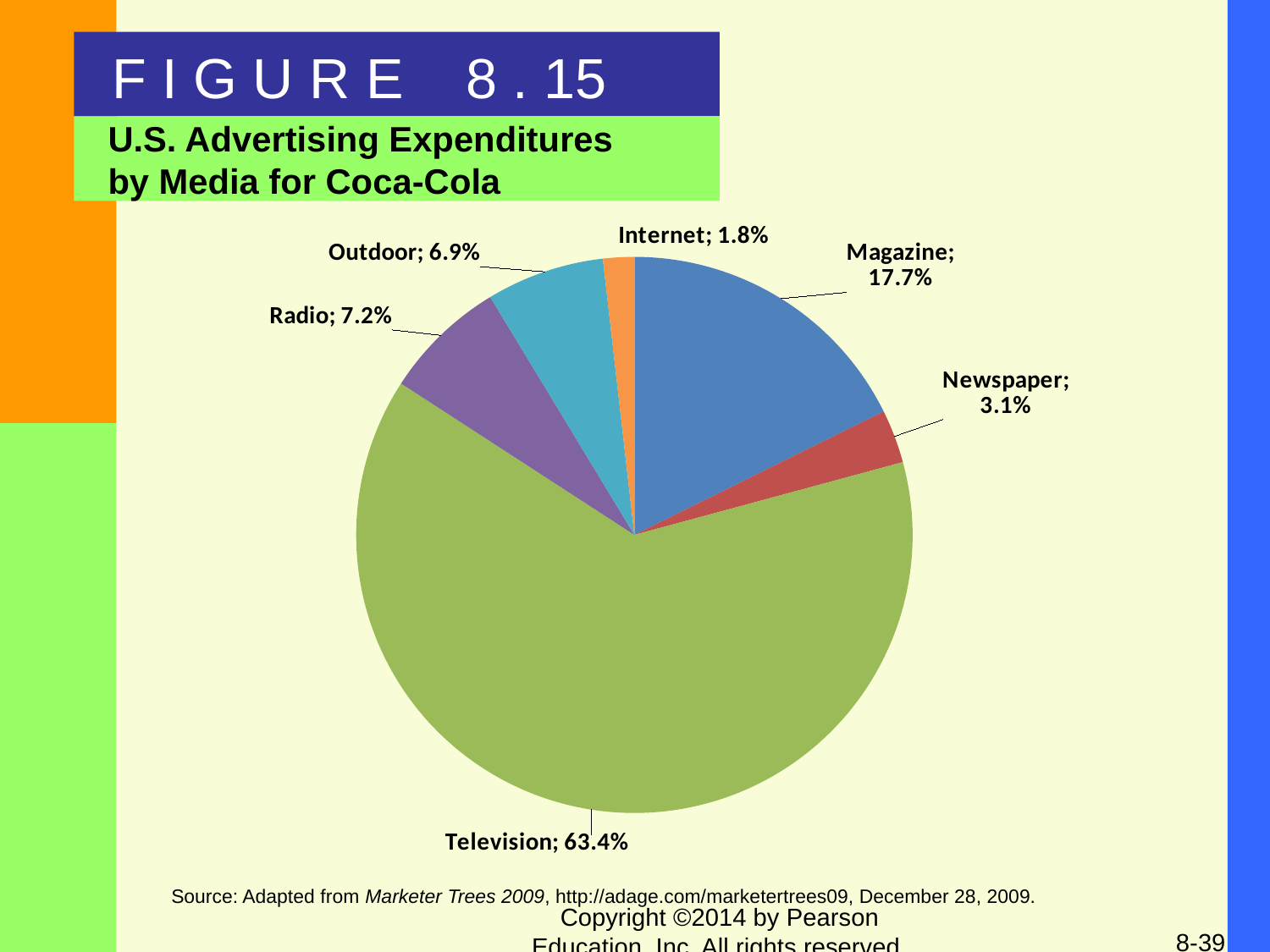
Which is larger, the Radio share or the Outdoor share? Radio What is the title of the figure shown on the slide? U.S. Advertising Expenditures by Media for Coca-Cola What is the difference between the Magazine share and the Newspaper share? 14.6% What percentage of the pie is Magazine? 17.7% What is the value shown for Radio? 7.2% Which media category has the smallest share of the pie? Internet How many media categories are shown in the pie chart? 6 What kind of chart is shown on the slide? Pie chart What is the value shown for Internet? 1.8% What share of U.S. advertising expenditures for Coca-Cola goes to Television? 63.4% What is the combined share of Radio and Outdoor? 14.1% Which media category has the largest share of the pie? Television